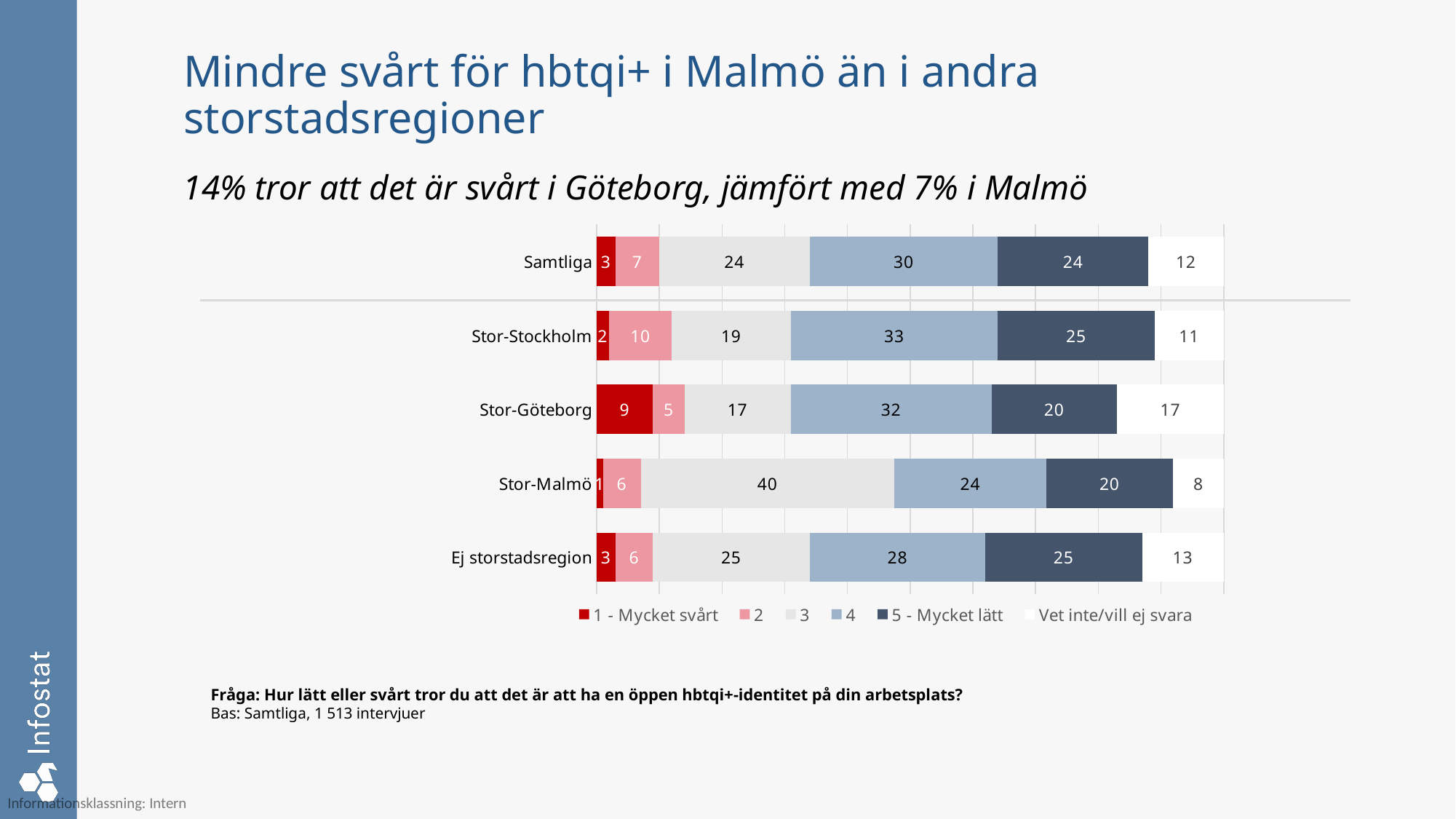
Which category has the highest value for "1 - Mycket svårt"? Stor-Göteborg What is the value for "1 - Mycket svårt" in the Stor-Göteborg bar? 9 What is the value for "Vet inte/vill ej svara" in the Samtliga bar? 12 How many series does the legend list? 6 How many categories are shown on the chart? 5 What is the difference between the "4" values for Stor-Stockholm and Stor-Malmö? 9 What is the value for "3" in the Stor-Malmö bar? 40 What kind of chart is shown on the slide? Stacked bar chart Which is larger: the "2" value for Stor-Stockholm or for Stor-Göteborg? Stor-Stockholm Which category has the lowest value for "Vet inte/vill ej svara"? Stor-Malmö What is the total of the Stor-Göteborg bar? 100 What is the value for "5 - Mycket lätt" in the Stor-Stockholm bar? 25